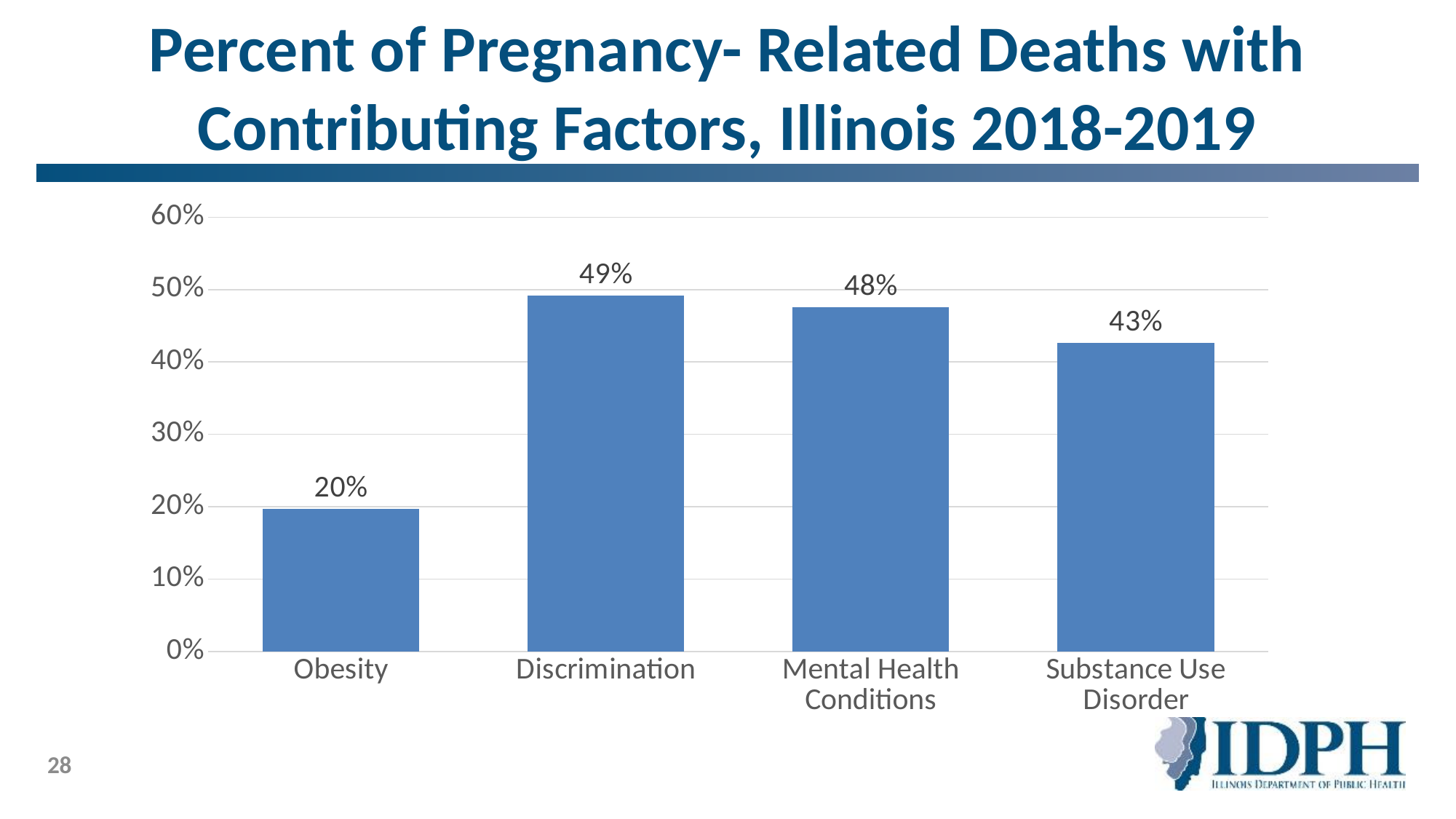
Which contributing factor has the lowest percentage? Obesity What is the value shown for Discrimination? 49% Is the value for Substance Use Disorder greater or less than 40%? greater What percent of pregnancy-related deaths had Obesity as a contributing factor? 20% Which contributing factor has the highest percentage? Discrimination What is the difference between the values for Mental Health Conditions and Substance Use Disorder? 5% Which is larger, the value for Substance Use Disorder or the value for Obesity? Substance Use Disorder What is the value shown for Substance Use Disorder? 43% How many contributing factors are shown on the chart? 4 What is the value shown for Mental Health Conditions? 48% What is the difference between the values for Discrimination and Obesity? 29% What kind of chart is shown on the slide? Bar chart